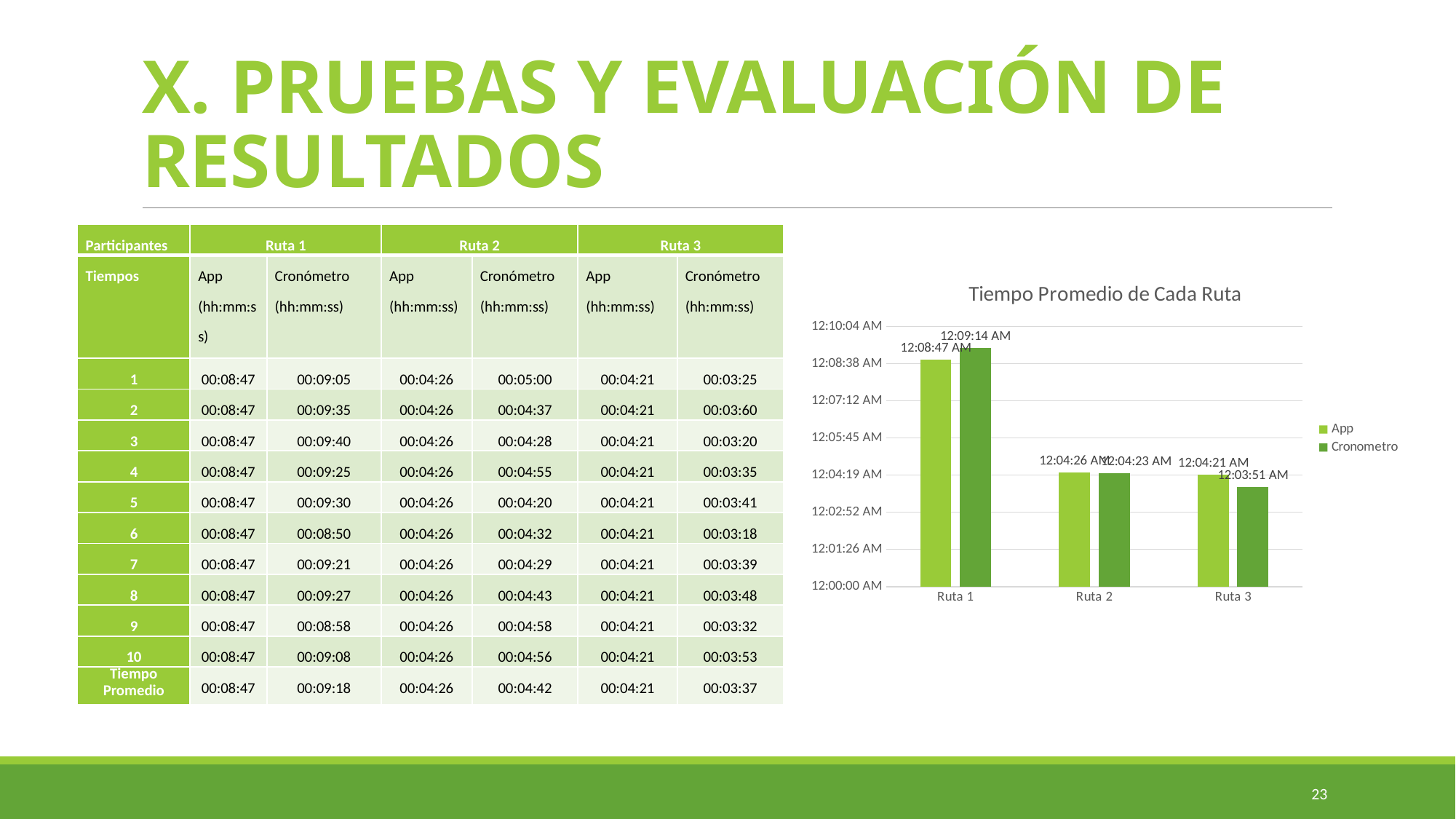
How many routes (categories) are shown on the x axis of the chart? 3 For Ruta 1, which is larger in the chart: the App bar or the Cronometro bar? Cronometro What kind of chart is shown on the slide? bar chart Which route has the lowest Cronometro value in the chart? Ruta 3 Which route has the highest Cronometro value in the chart? Ruta 1 What is the Cronometro value for Ruta 3 in the chart? 12:03:51 AM What is the title of the chart? Tiempo Promedio de Cada Ruta How many series does the chart legend list? 2 Which series is shown in the darker green colour in the chart? Cronometro What is the App value for Ruta 3 in the chart? 12:04:21 AM What is the Cronometro value for Ruta 1 in the chart? 12:09:14 AM What is the App value for Ruta 1 in the chart? 12:08:47 AM